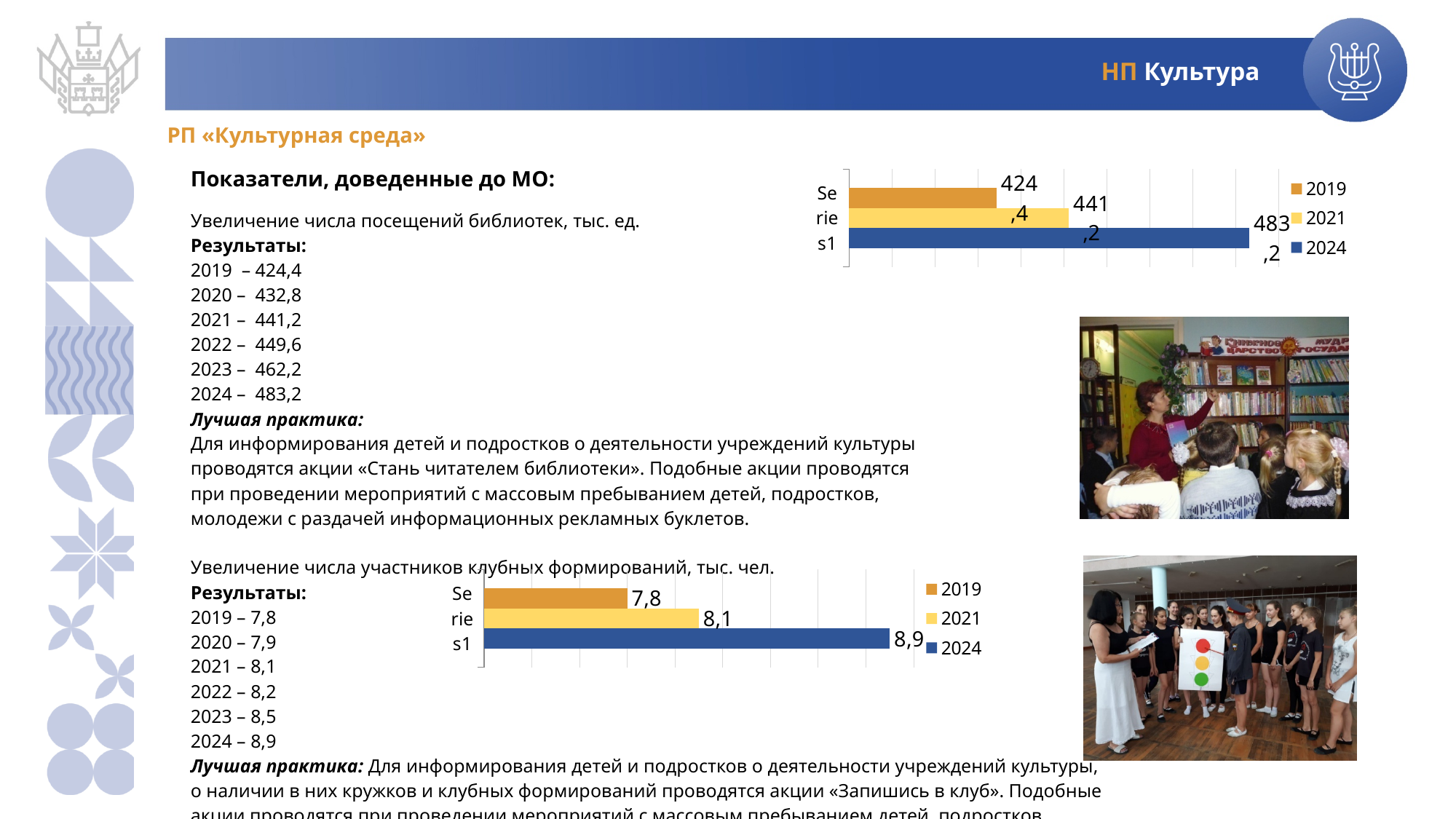
On the top chart, how many series does the legend list? 3 On the bottom chart, which year has the lowest value? 2019 On the bottom chart, which is larger, the value for 2021 or the value for 2024? 2024 On the top chart, which year has the highest value? 2024 On the bottom chart, what is the difference between the 2024 and 2019 values? 1,1 On the bottom chart, what is the value for 2021? 8,1 On the bottom chart, what is the value for 2024? 8,9 On the top chart, what is the value for 2019? 424,4 What type of chart is the bottom chart? Bar chart On the top chart, which colour represents 2024 in the legend? Blue On the top chart, what is the difference between the 2024 and 2019 values? 58,8 On the top chart, what is the value for 2024? 483,2